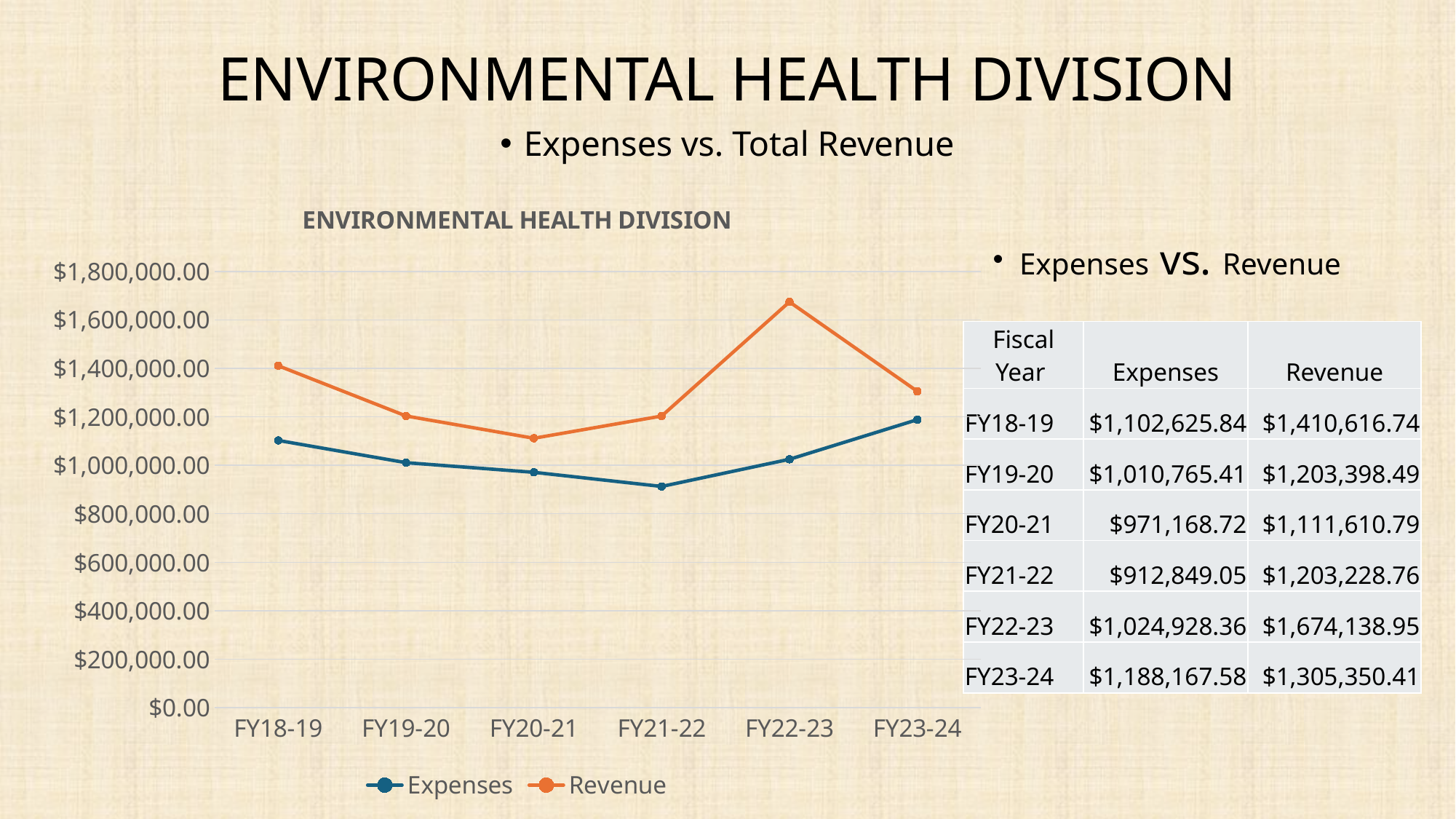
Do Expenses rise or fall from FY21-22 to FY23-24? Rise What kind of chart is shown on the slide? Line chart What were the Expenses for FY18-19? $1,102,625.84 Is the Revenue value for FY22-23 greater or less than $1,600,000.00? greater In which fiscal year is Revenue highest? FY22-23 Is the Expenses value for FY21-22 greater or less than $1,000,000.00? less In FY23-24, which is larger, Expenses or Revenue? Revenue What was the Revenue for FY22-23? $1,674,138.95 In which fiscal year are Expenses lowest? FY21-22 How many fiscal years are plotted along the x axis of the chart? 6 How many series does the chart legend list? 2 What is the difference between Revenue and Expenses in FY22-23? $649,210.59